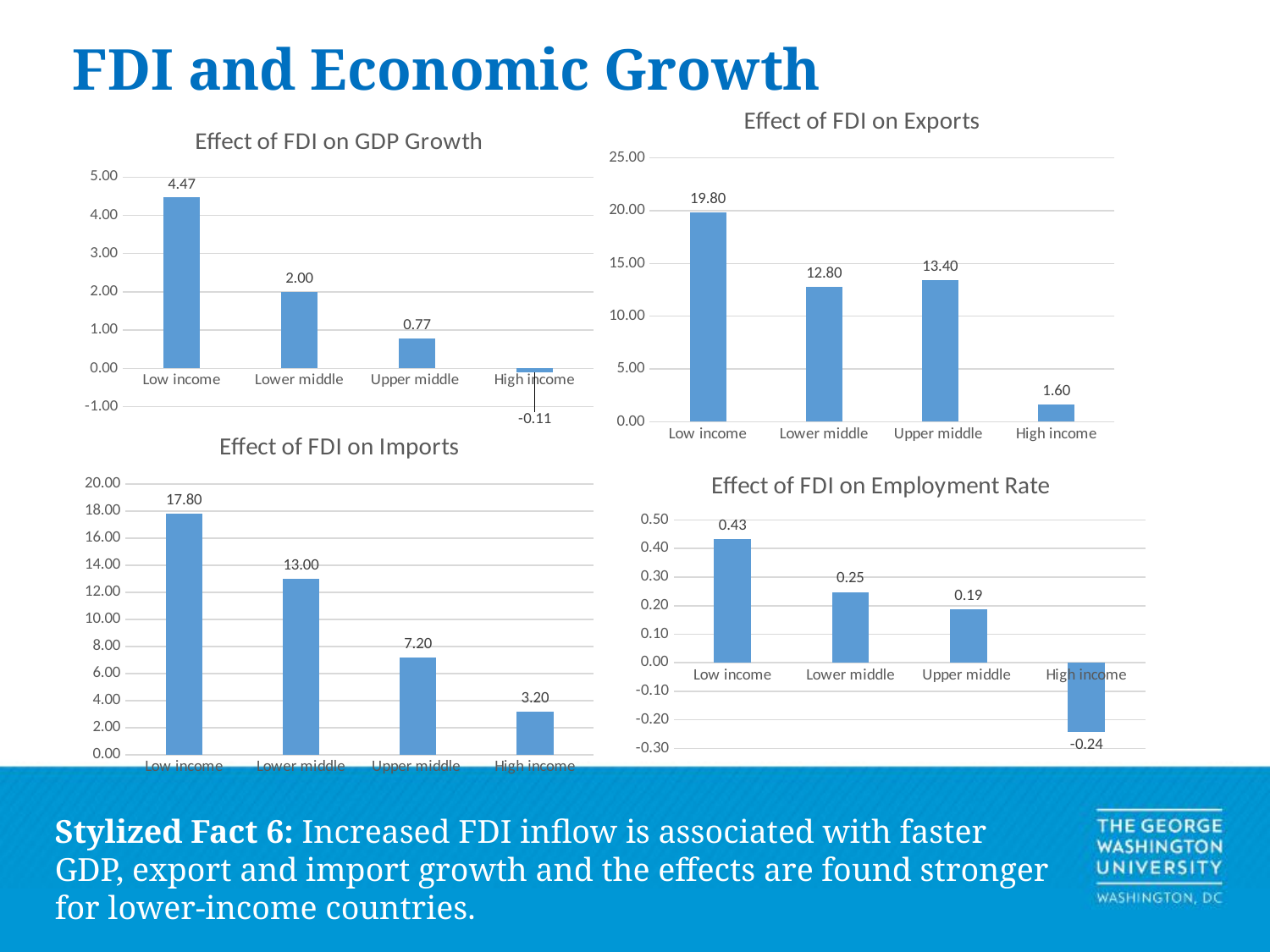
In the 'Effect of FDI on Imports' chart, which category has the lowest value? High income In the 'Effect of FDI on Exports' chart, what is the difference between the Upper middle and Lower middle values? 0.60 In the 'Effect of FDI on GDP Growth' chart, what is the value for Low income? 4.47 How many categories are shown in the 'Effect of FDI on Exports' chart? 4 In the 'Effect of FDI on Exports' chart, which category has the highest value? Low income What kind of chart is the 'Effect of FDI on GDP Growth' chart? Bar chart In the 'Effect of FDI on GDP Growth' chart, what is the value for High income? -0.11 In the 'Effect of FDI on Employment Rate' chart, what is the value for Lower middle? 0.25 In the 'Effect of FDI on Imports' chart, what is the value for Upper middle? 7.20 In the 'Effect of FDI on Employment Rate' chart, which is larger: the value for Low income or the value for Upper middle? Low income In the 'Effect of FDI on Imports' chart, do the values rise or fall from Low income to High income? Fall In the 'Effect of FDI on Imports' chart, what is the difference between the Low income and Lower middle values? 4.80